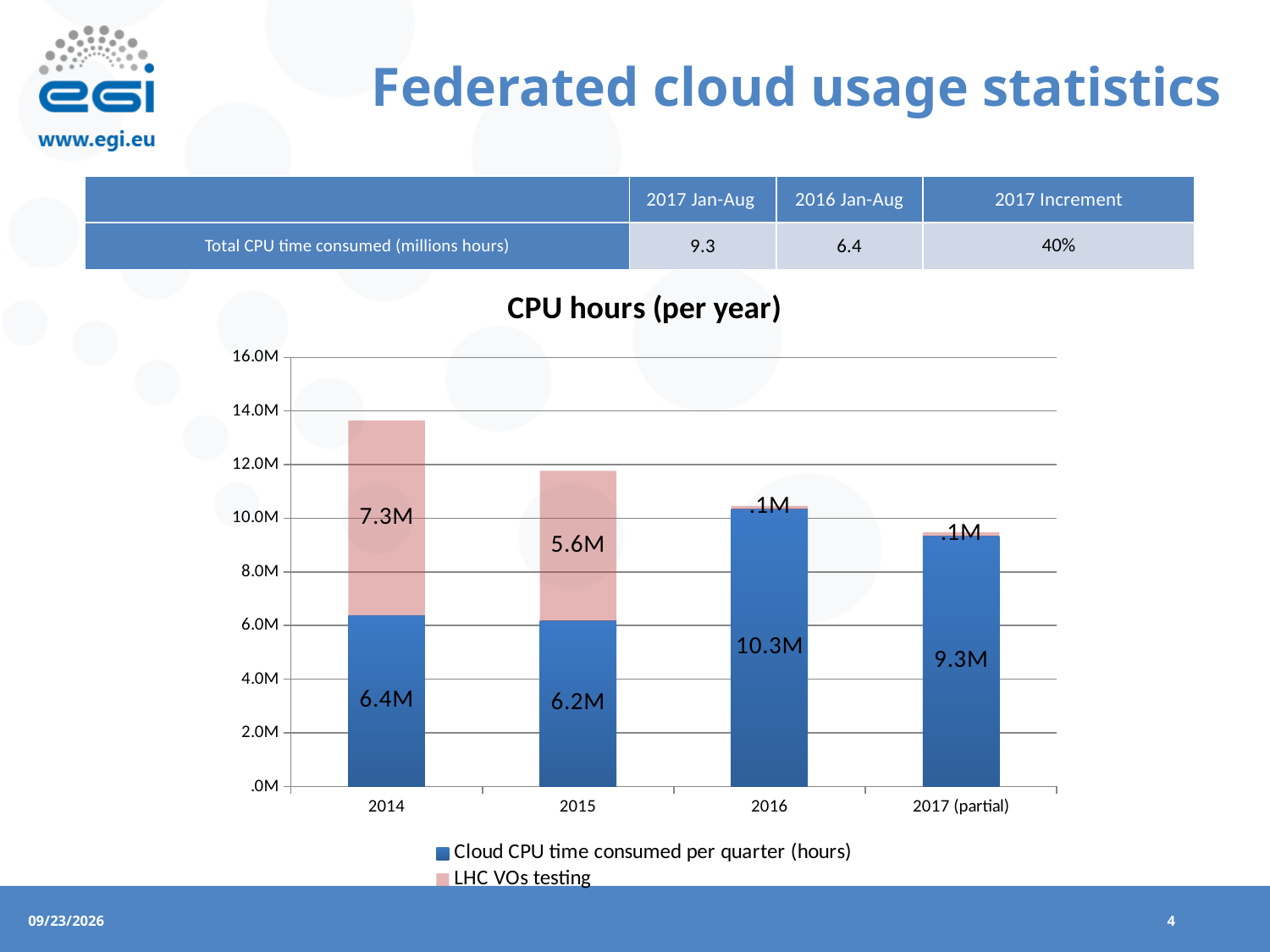
How many year categories are shown on the x axis of the chart? 4 Is the total stacked bar for 2015 greater or less than 12.0M? less What kind of chart is shown on the slide? Stacked bar chart Which year has the highest value for Cloud CPU time consumed per quarter (hours)? 2016 What is the total of the stacked bar for 2014? 13.7M What is the difference between the Cloud CPU time consumed per quarter (hours) values for 2016 and 2015? 4.1M Which year has the lowest value for LHC VOs testing? 2016 and 2017 (partial) What is the value of LHC VOs testing for 2014? 7.3M What is the value of Cloud CPU time consumed per quarter (hours) for 2017 (partial)? 9.3M What is the title of the chart? CPU hours (per year) What is the value of Cloud CPU time consumed per quarter (hours) for 2016? 10.3M How many series does the chart legend list? 2